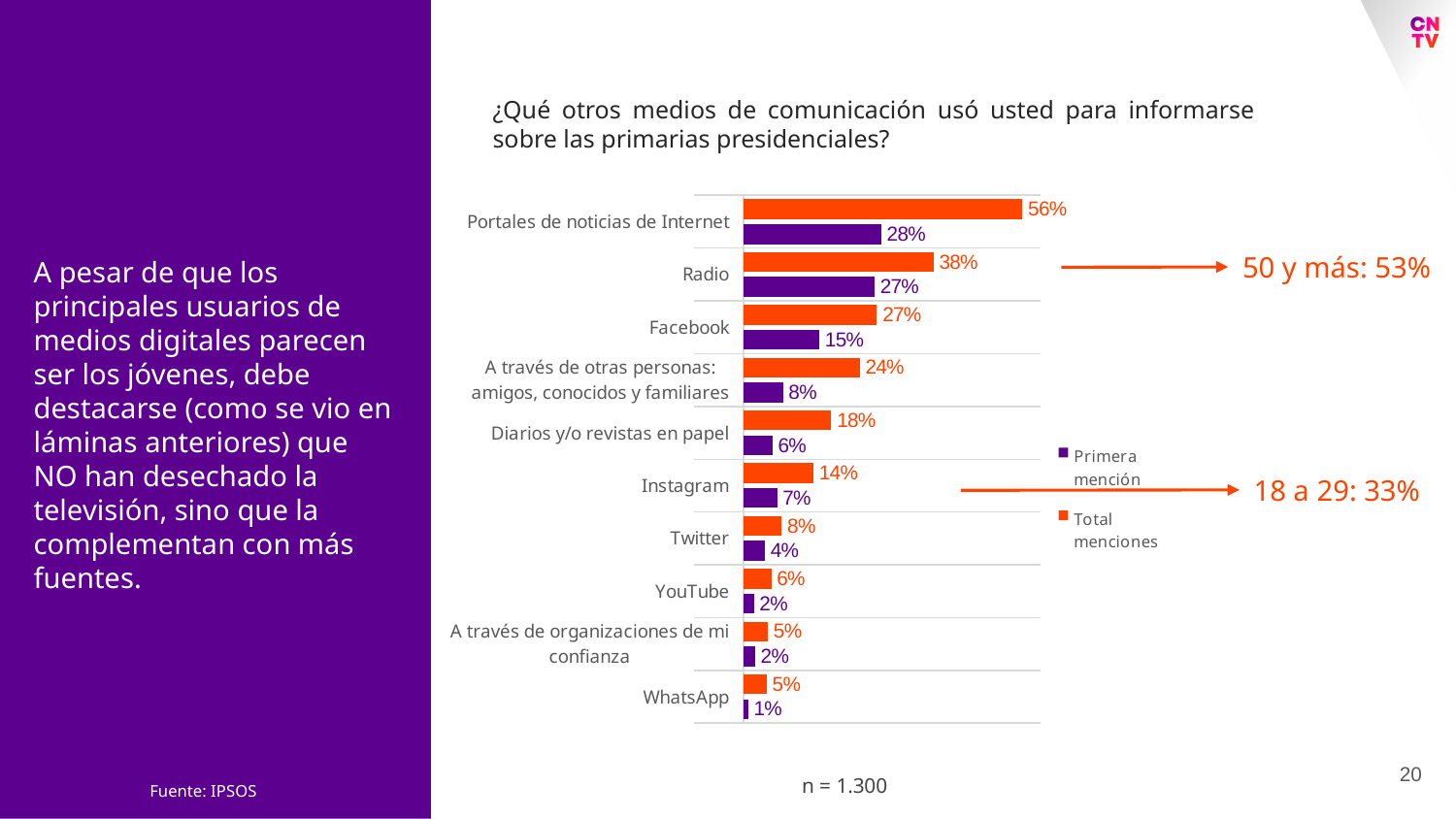
Which category has the lowest 'Primera mención' value? WhatsApp What is the difference between the 'Total menciones' and 'Primera mención' values for Portales de noticias de Internet? 28% Which category has the highest 'Total menciones' value? Portales de noticias de Internet What is the difference between the 'Total menciones' values for Radio and Twitter? 30% What is the 'Total menciones' value for Radio? 38% Which is larger: the 'Total menciones' value for Facebook or for Diarios y/o revistas en papel? Facebook How many categories are shown in the chart? 10 What kind of chart is shown on the slide? Bar chart How many series does the legend list? 2 What is the 'Total menciones' value for Instagram? 14% Which series is shown in orange in the chart? Total menciones What is the 'Primera mención' value for Facebook? 15%